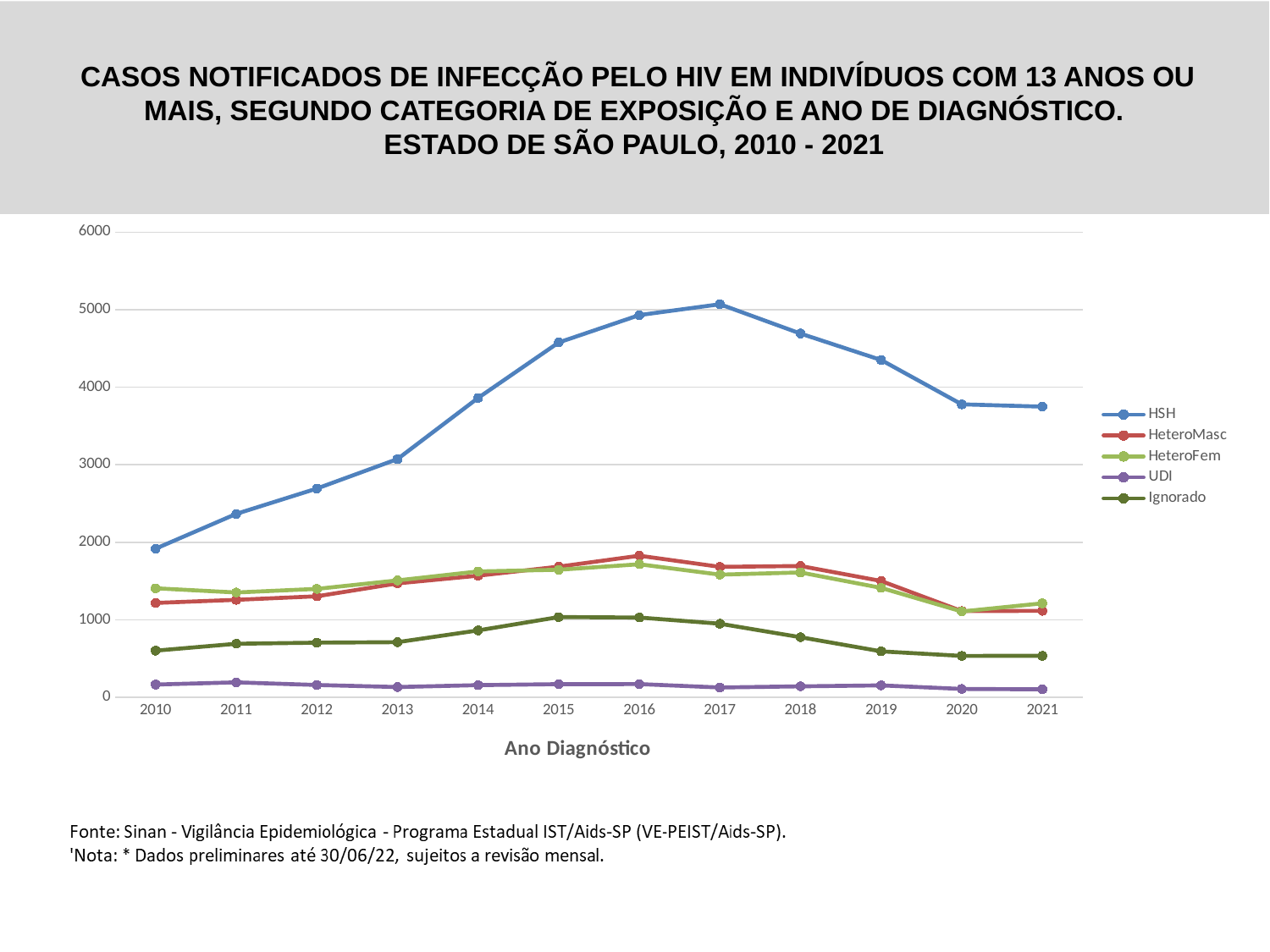
What is the title of the x axis? Ano Diagnóstico In which year does the HSH series reach its highest value? 2017 How many series does the legend list? 5 Which is larger: the HSH value in 2016 or the HSH value in 2020? 2016 Which series has the lowest values across the whole period? UDI Is the value for HeteroMasc in 2016 greater or less than 1000? greater What kind of chart is shown on the slide? line chart How many years are plotted along the x axis? 12 Is the value for HSH in 2012 greater or less than 2000? greater Do the HSH values rise or fall from 2017 to 2021? fall Which series has the highest values across the whole period? HSH Is the value for HSH in 2020 greater or less than 4000? less